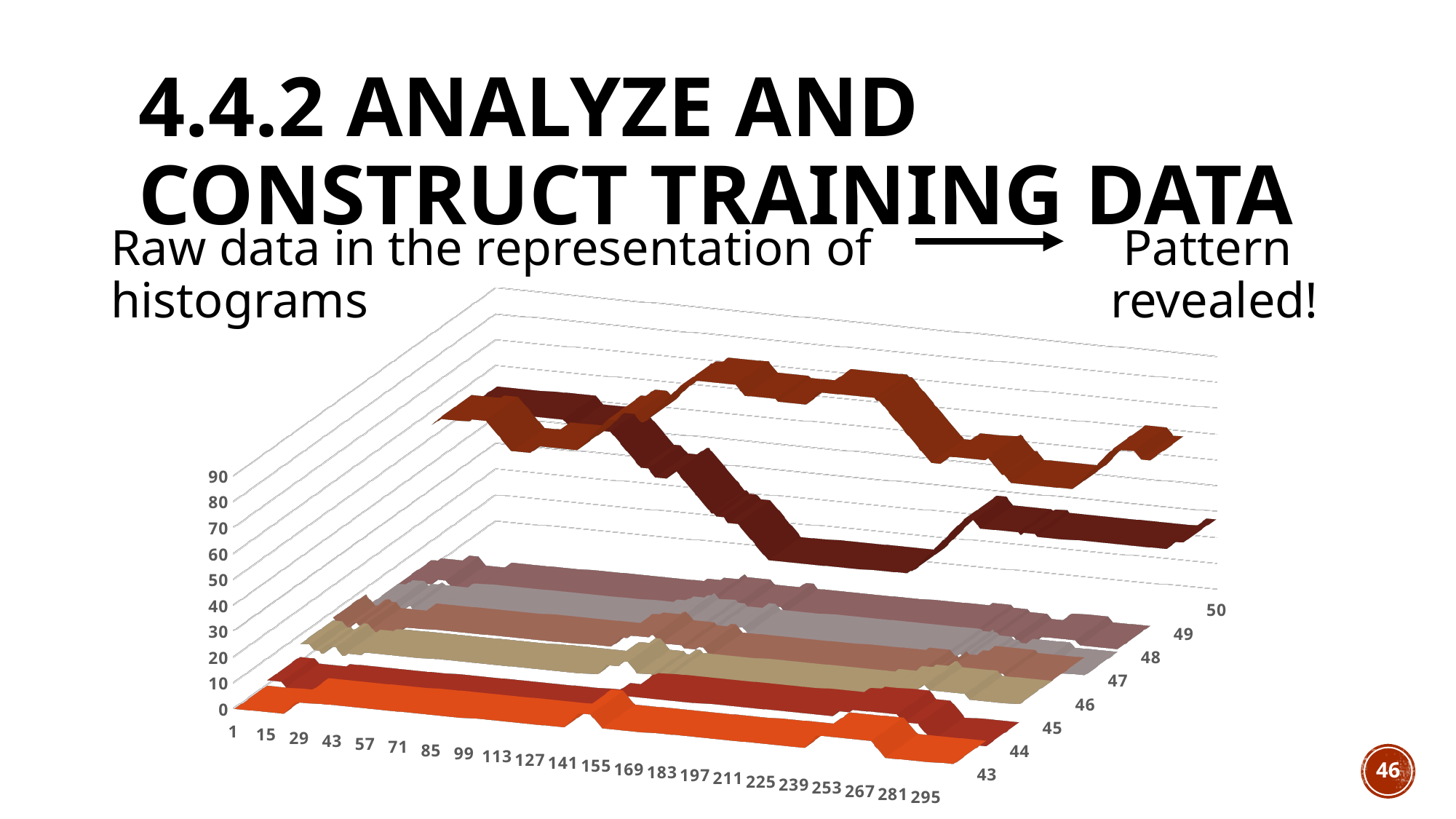
How many category labels are shown along the horizontal axis of the chart? 22 How many series (depth-axis labels from 43 to 50) are plotted in the chart? 8 What kind of chart is shown on the slide? 3D ribbon (line) chart What is the highest tick value shown on the vertical axis of the chart? 90 What is the first category label on the horizontal axis of the chart? 1 What is the highest depth-axis label shown in the chart? 50 What is the lowest depth-axis label shown in the chart? 43 What is the last category label on the horizontal axis of the chart? 295 What is the interval between consecutive tick marks on the vertical axis of the chart? 10